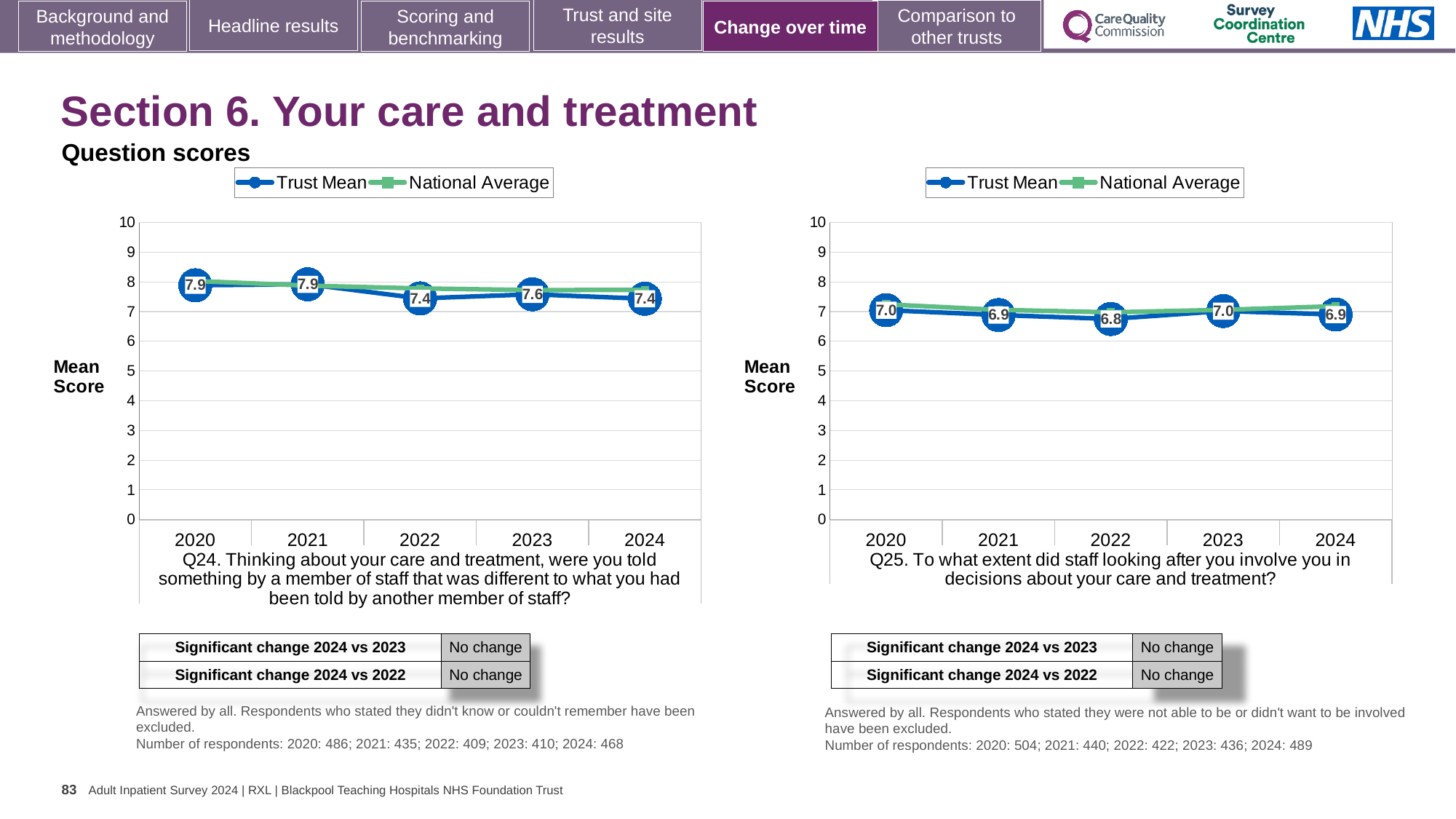
In the Q24 chart on the left, what is the difference between the Trust Mean scores for 2021 and 2022? 0.5 In the Q24 chart on the left, is the National Average value for 2020 greater or less than 7? greater In the Q24 chart on the left, what is the Trust Mean score for 2022? 7.4 In the Q25 chart on the right, what is the Trust Mean score for 2023? 7.0 In the Q25 chart on the right, what is the difference between the Trust Mean scores for 2020 and 2022? 0.2 In the Q24 chart on the left, which year has the larger Trust Mean score, 2021 or 2024? 2021 In the Q25 chart on the right, which year has the lowest Trust Mean score? 2022 What kind of chart is the Q24 chart on the left? Line chart In the Q25 chart on the right, is the National Average value for 2022 greater or less than 8? less In the Q24 chart on the left, what is the Trust Mean score for 2020? 7.9 How many series does the legend of the Q24 chart on the left list? 2 How many years are plotted on the x axis of the Q25 chart on the right? 5